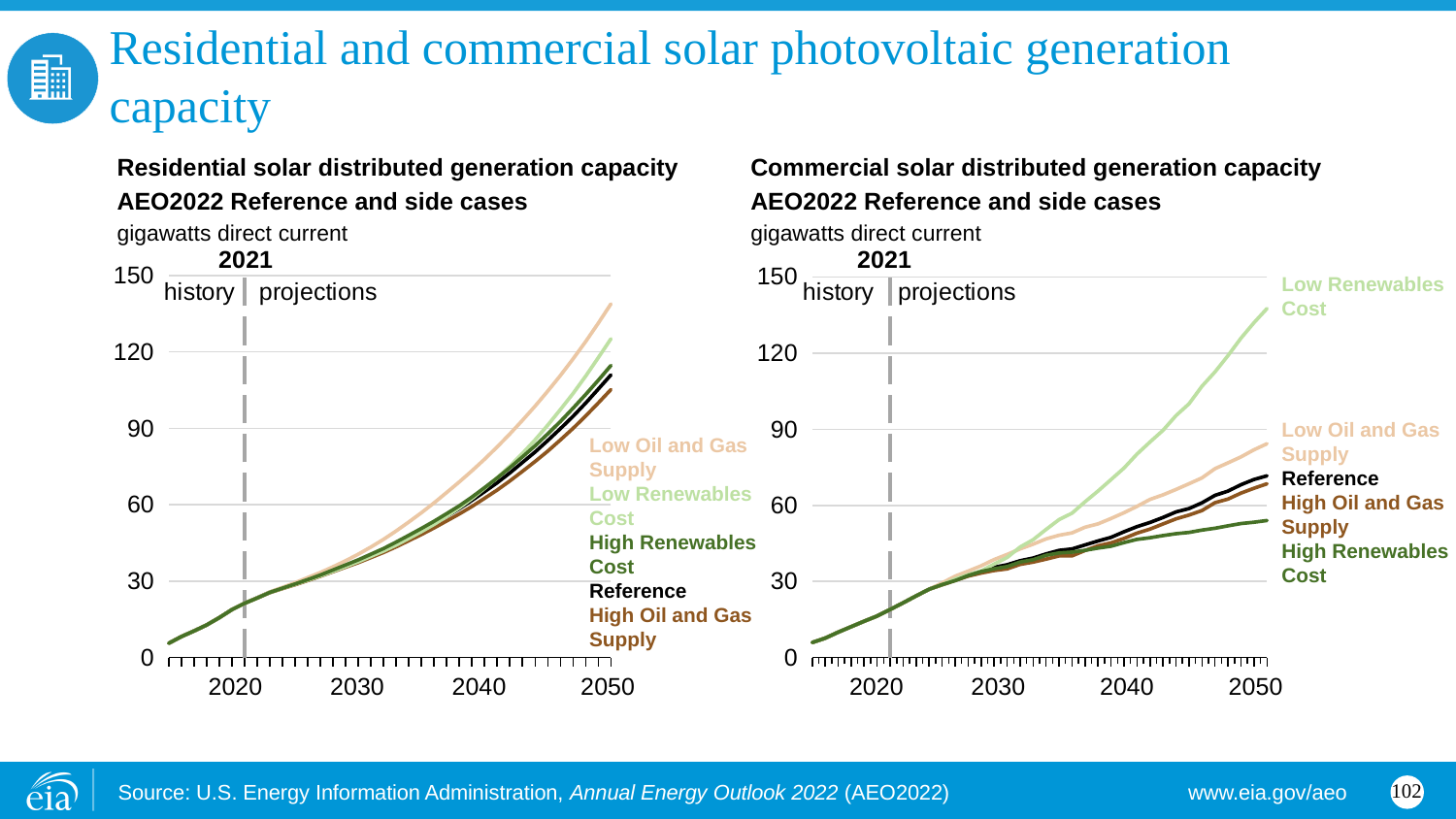
In the Commercial solar distributed generation capacity chart, which case has the lowest value in 2050? High Renewables Cost In the Residential solar distributed generation capacity chart, which case has the highest value in 2050? Low Oil and Gas Supply In the Commercial solar distributed generation capacity chart, which case has the highest value in 2050? Low Renewables Cost In the Residential solar distributed generation capacity chart, is the 2050 value for Low Oil and Gas Supply greater or less than 120? greater What type of chart is the Residential solar distributed generation capacity chart? line chart In the Commercial solar distributed generation capacity chart, is the 2050 value for Low Renewables Cost greater or less than 120? greater How many series does the Commercial solar distributed generation capacity chart show? 5 In the Residential solar distributed generation capacity chart, do the values rise or fall from 2020 to 2050? rise In the Commercial solar distributed generation capacity chart, which is larger in 2050: Reference or High Renewables Cost? Reference In the Commercial solar distributed generation capacity chart, is the 2050 value for High Renewables Cost greater or less than 60? less In the Residential solar distributed generation capacity chart, which case has the lowest value in 2050? High Oil and Gas Supply What unit is used on the y axis of both charts? gigawatts direct current